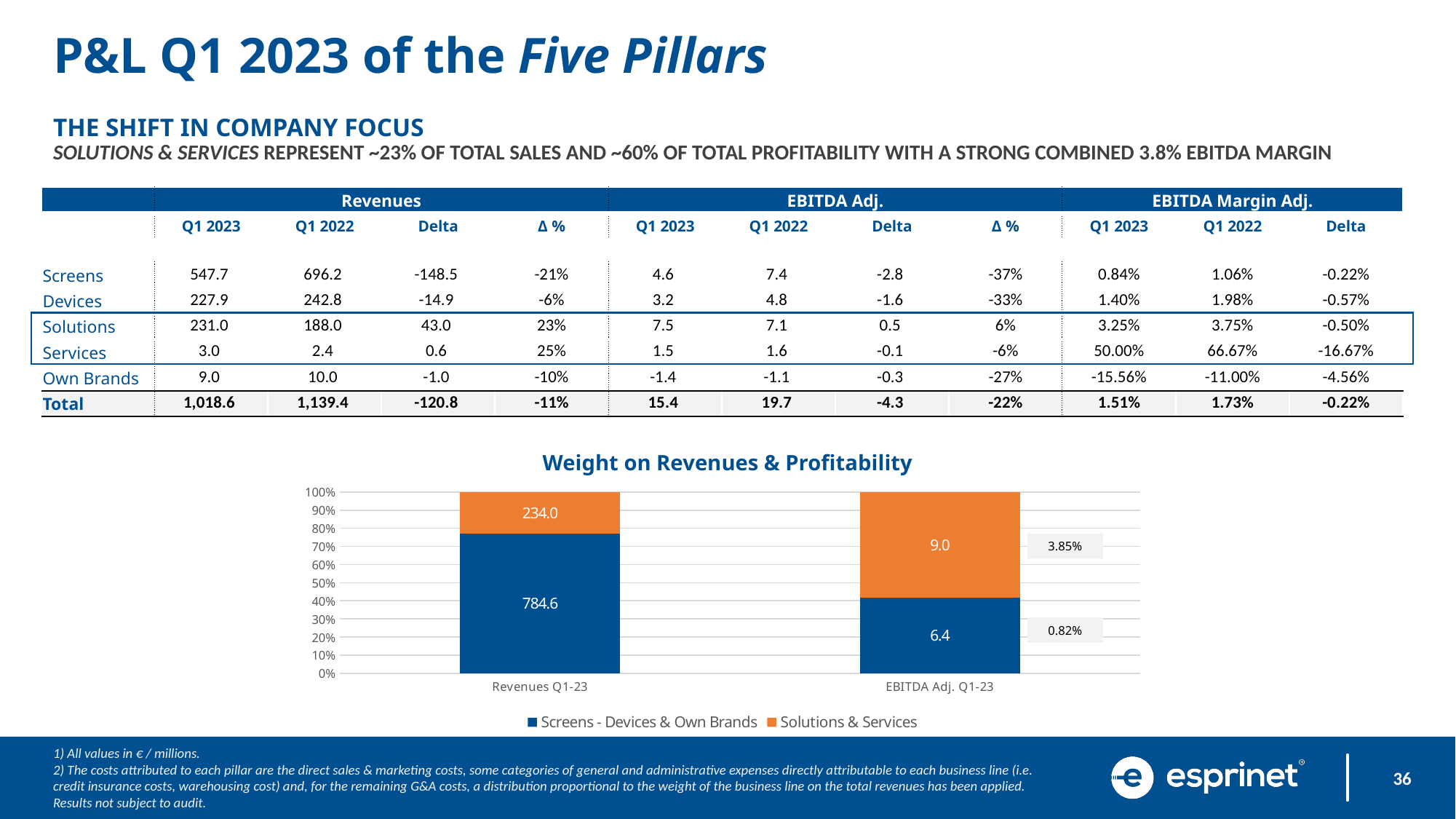
In the 'Weight on Revenues & Profitability' chart, which segment is larger in the EBITDA Adj. Q1-23 bar: Screens - Devices & Own Brands or Solutions & Services? Solutions & Services In the 'Weight on Revenues & Profitability' chart, what is the value of the Screens - Devices & Own Brands segment for EBITDA Adj. Q1-23? 6.4 In the 'Weight on Revenues & Profitability' chart, what is the total of the two segments in the EBITDA Adj. Q1-23 bar? 15.4 In the 'Weight on Revenues & Profitability' chart, what is the value of the Screens - Devices & Own Brands segment for Revenues Q1-23? 784.6 In the 'Weight on Revenues & Profitability' chart, what is the value of the Solutions & Services segment for EBITDA Adj. Q1-23? 9.0 In the 'Weight on Revenues & Profitability' chart, which colour represents the Solutions & Services series? orange What type of chart is shown under the title 'Weight on Revenues & Profitability'? stacked bar chart In the 'Weight on Revenues & Profitability' chart, what is the value of the Solutions & Services segment for Revenues Q1-23? 234.0 In the 'Weight on Revenues & Profitability' chart, how many series does the legend list? 2 In the 'Weight on Revenues & Profitability' chart, what is the difference between the Screens - Devices & Own Brands and Solutions & Services segments in the Revenues Q1-23 bar? 550.6 In the 'Weight on Revenues & Profitability' chart, how many bars (categories) are plotted on the x axis? 2 In the 'Weight on Revenues & Profitability' chart, what is the total of the two segments in the Revenues Q1-23 bar? 1,018.6